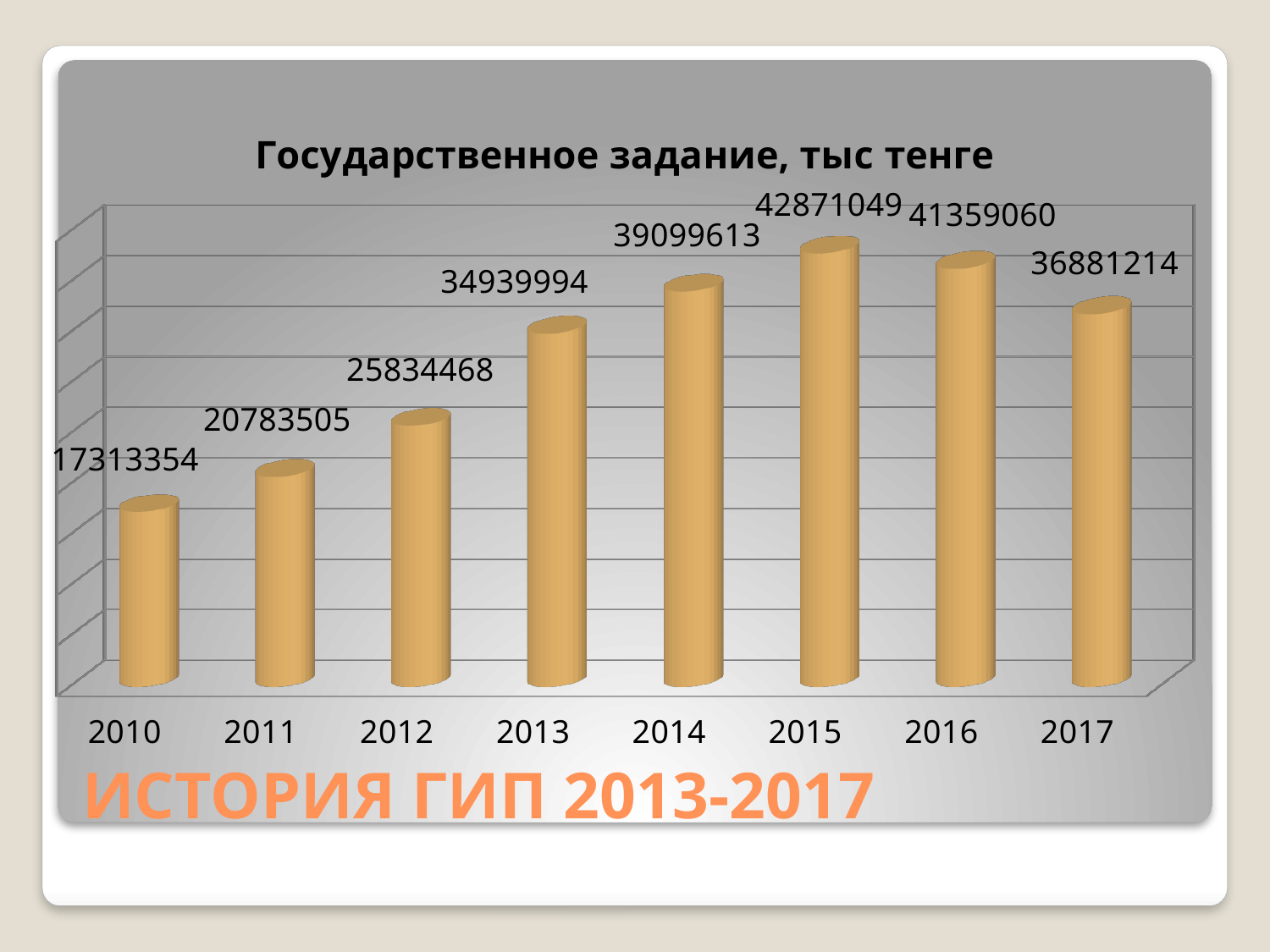
Do the values rise or fall from 2010 to 2015? rise What is the difference between the values for 2015 and 2014? 3771436 What is the difference between the values for 2016 and 2017? 4477846 Which year has the lowest value in the chart? 2010 How many years are shown in the chart? 8 Which year has the highest value in the chart? 2015 What is the value for 2010 in the chart? 17313354 What is the value for 2017 in the chart? 36881214 Which is larger, the value for 2016 or the value for 2017? 2016 What is the title of the chart? Государственное задание, тыс тенге What is the value for 2015 in the chart? 42871049 What kind of chart is shown on the slide? bar chart